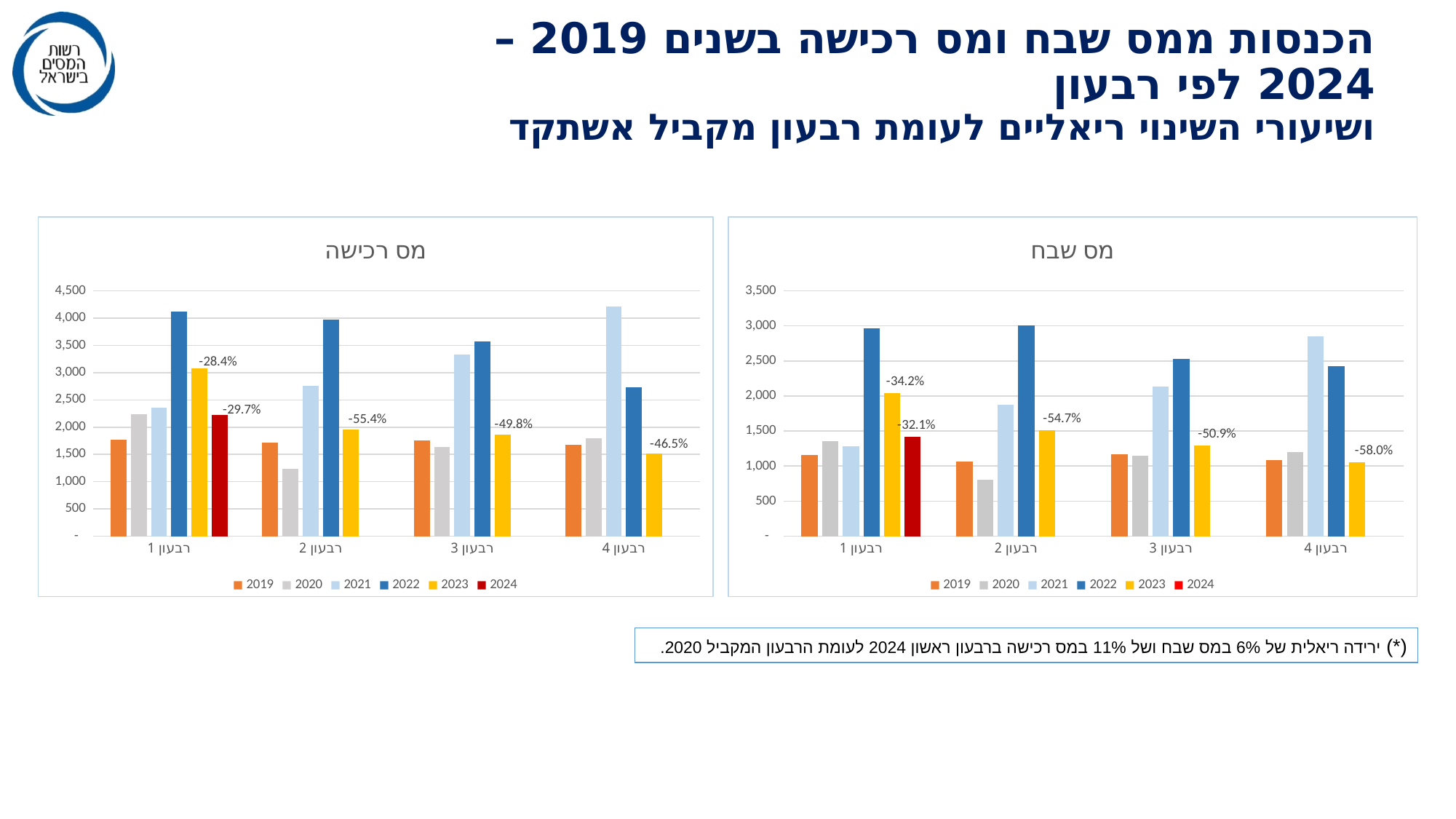
In the מס רכישה chart, which year has the highest bar in רבעון 1? 2022 In the מס רכישה chart, what is the data label shown on the 2023 bar for רבעון 2? -55.4% In the מס רכישה chart, what is the data label shown on the 2024 bar for רבעון 1? -29.7% In the מס שבח chart, which year has the lowest bar in רבעון 2? 2020 What kind of chart is the מס שבח chart? bar chart In the מס שבח chart, what is the data label shown on the 2023 bar for רבעון 4? -58.0% In the מס שבח chart, is the value for 2020 in רבעון 2 greater or less than 1,000? less In the מס שבח chart, what is the data label shown on the 2024 bar for רבעון 1? -32.1% How many series does the legend of the מס שבח chart list? 6 In the מס רכישה chart, what is the data label shown on the 2023 bar for רבעון 1? -28.4% How many quarter categories are shown on the x axis of the מס רכישה chart? 4 In the מס רכישה chart, is the value for 2022 in רבעון 1 greater or less than 4,000? greater